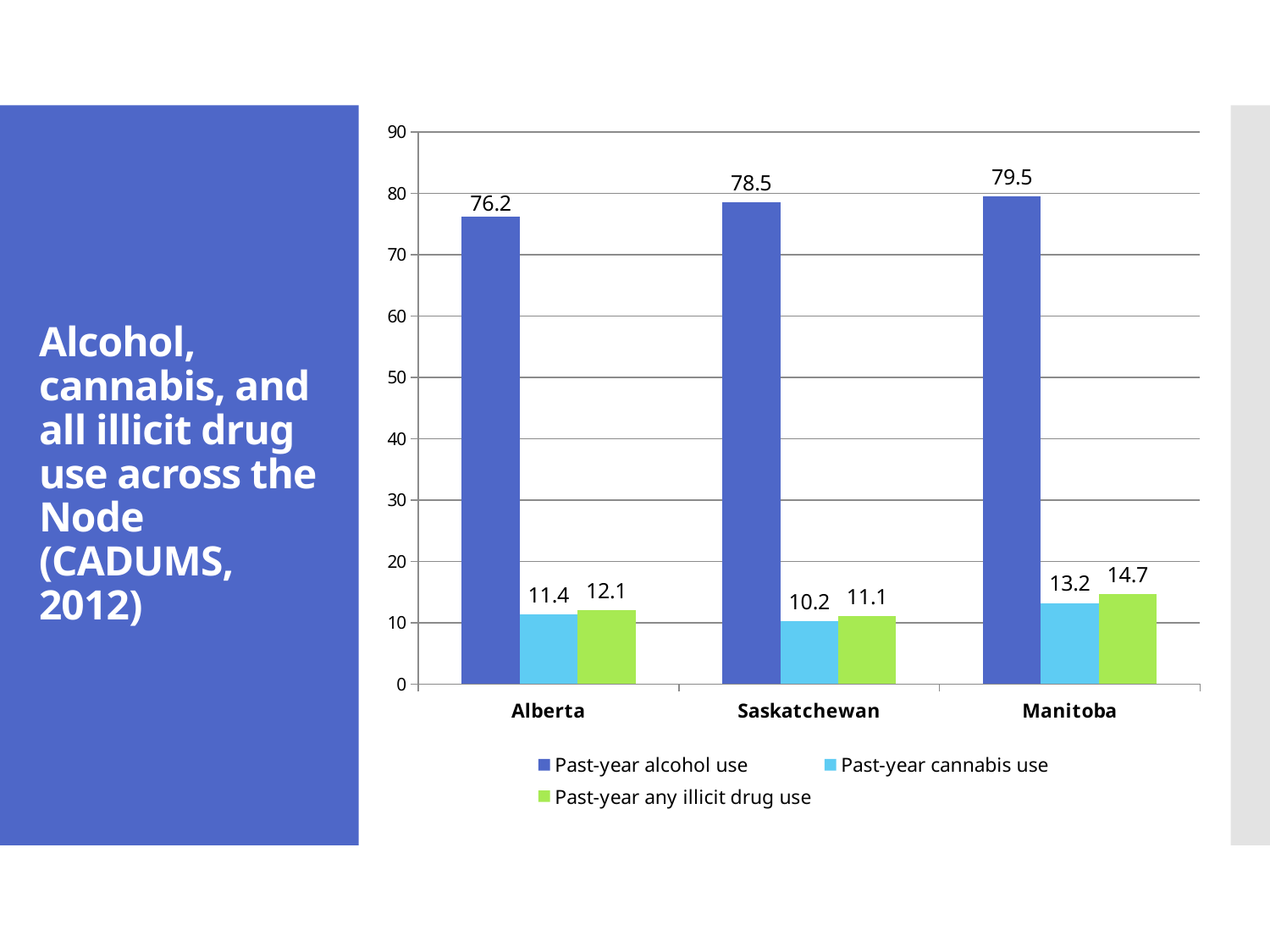
Which colour represents past-year cannabis use in the legend? Light blue What is the difference between past-year alcohol use in Manitoba and Alberta? 3.3 How many provinces are shown on the x axis? 3 What kind of chart is shown on the slide? Bar chart What is the past-year alcohol use value for Alberta? 76.2 What is the past-year cannabis use value for Saskatchewan? 10.2 Is the past-year alcohol use value for Saskatchewan greater or less than 70? greater How many series does the legend list? 3 What is the past-year any illicit drug use value for Manitoba? 14.7 Which is larger: past-year any illicit drug use in Alberta or in Saskatchewan? Alberta Which province has the lowest past-year cannabis use? Saskatchewan Which province has the highest past-year alcohol use? Manitoba